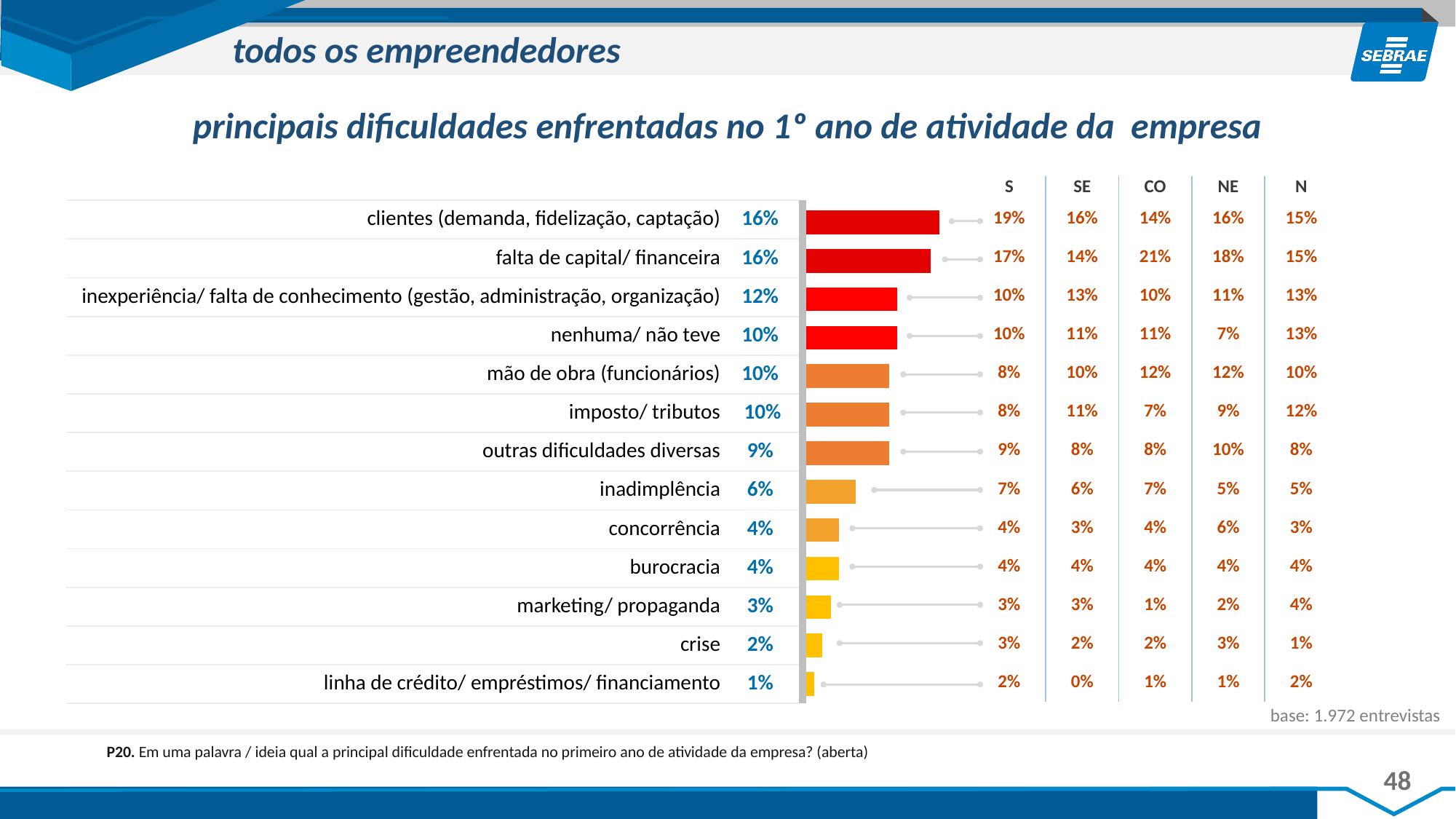
What is the overall value shown for "inexperiência/ falta de conhecimento (gestão, administração, organização)"? 12% What is the title of the chart on the slide? principais dificuldades enfrentadas no 1º ano de atividade da empresa What is the difference between the overall values for "inexperiência/ falta de conhecimento" and "inadimplência"? 6 percentage points Which has a larger overall value: "outras dificuldades diversas" or "concorrência"? outras dificuldades diversas In the regional table, what is the value for "clientes (demanda, fidelização, captação)" in the S region? 19% What kind of chart is shown on the slide? bar chart What is the overall value shown for "inadimplência"? 6% Which category has the lowest overall value in the bar chart? linha de crédito/ empréstimos/ financiamento In the regional table, what is the value for "linha de crédito/ empréstimos/ financiamento" in the SE region? 0% In the regional table, what is the value for "falta de capital/ financeira" in the CO region? 21% What is the overall value shown for "crise"? 2% How many difficulty categories are plotted in the bar chart? 13